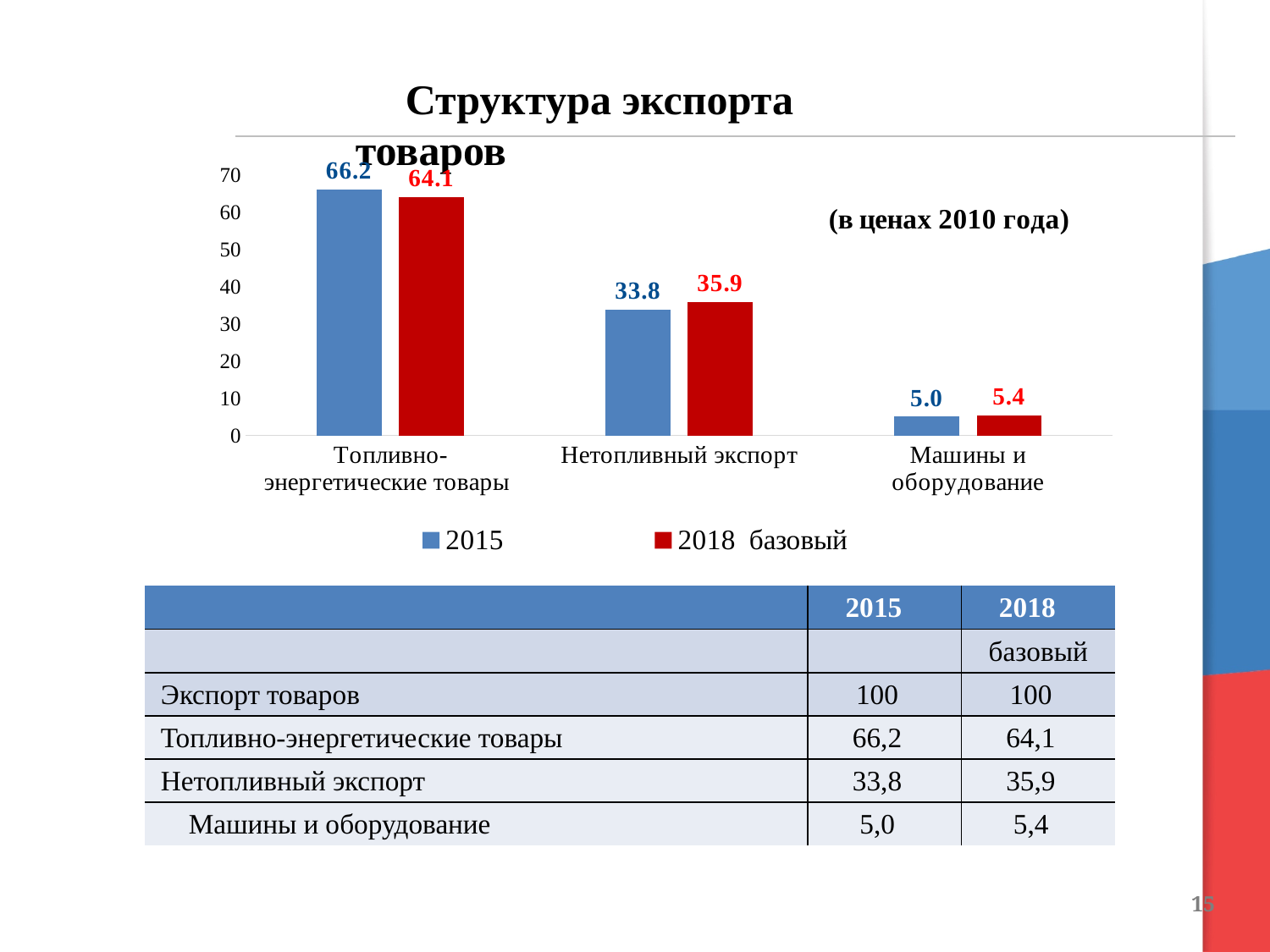
How many series does the chart legend list? 2 What is the value for Нетопливный экспорт in the 2018 базовый series? 35.9 What is the title of the chart? (в ценах 2010 года) What is the value for Машины и оборудование in the 2015 series? 5.0 What is the value for Топливно-энергетические товары in the 2015 series? 66.2 What is the value for Машины и оборудование in the 2018 базовый series? 5.4 Which category has the lowest value in the 2015 series? Машины и оборудование For Топливно-энергетические товары, which series has the larger value, 2015 or 2018 базовый? 2015 What type of chart is shown on the slide? bar chart Which category has the highest value in the 2018 базовый series? Топливно-энергетические товары What is the difference between the 2015 and 2018 базовый values for Нетопливный экспорт? 2.1 How many categories are shown on the x axis of the chart? 3